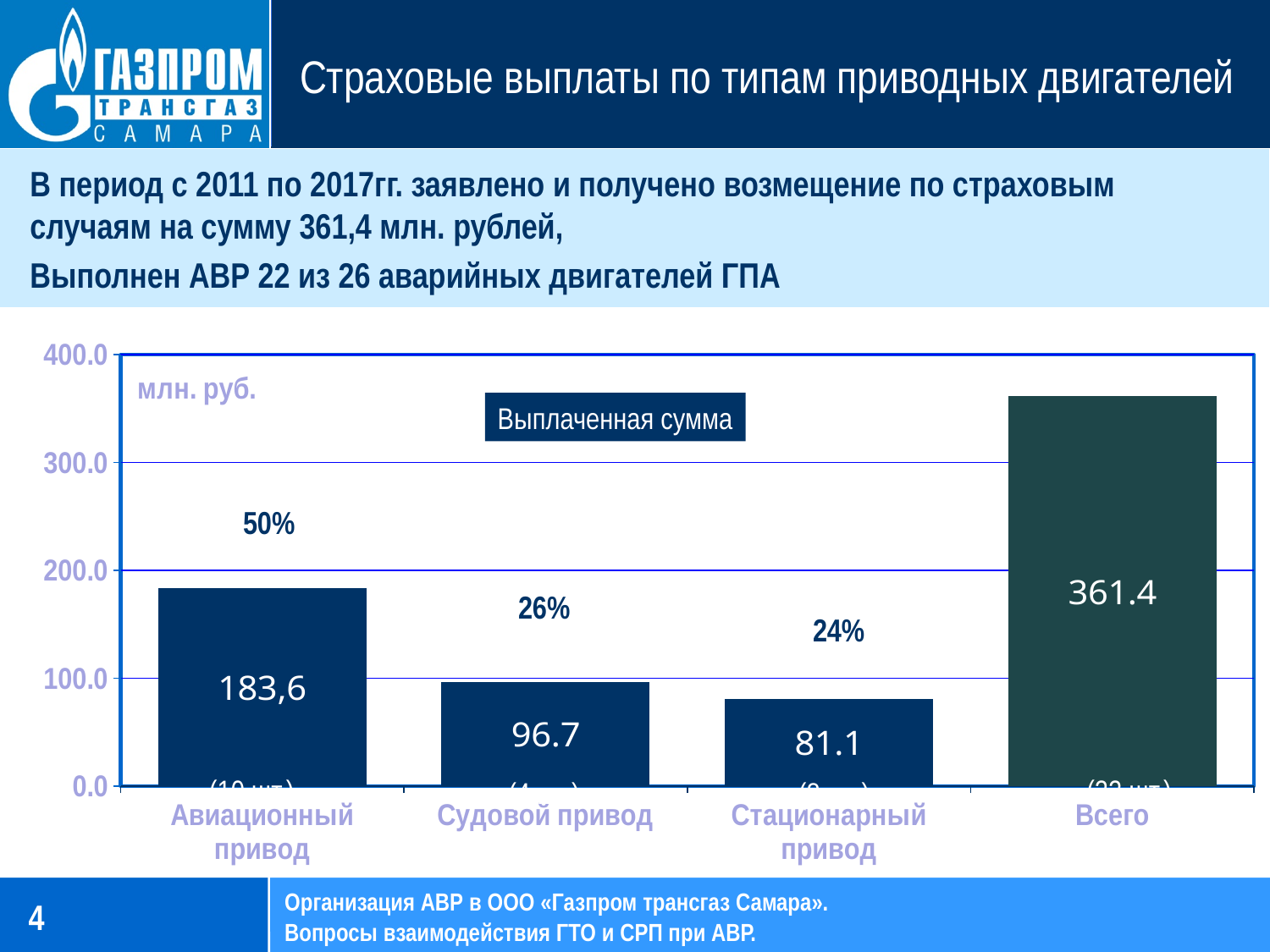
What is the value for Всего? 361.4 Which category has the highest value? Всего What is the value for Авиационный привод? 183,6 What kind of chart is shown on the slide? bar chart How many categories are shown on the x axis? 4 What is the difference between the values for Судовой привод and Стационарный привод? 15.6 Which category has the lowest value? Стационарный привод What is the legend entry shown on the chart? Выплаченная сумма What is the value for Стационарный привод? 81.1 Which is larger, the value for Авиационный привод or the value for Судовой привод? Авиационный привод What is the value for Судовой привод? 96.7 Is the value for Всего greater or less than 300.0? greater